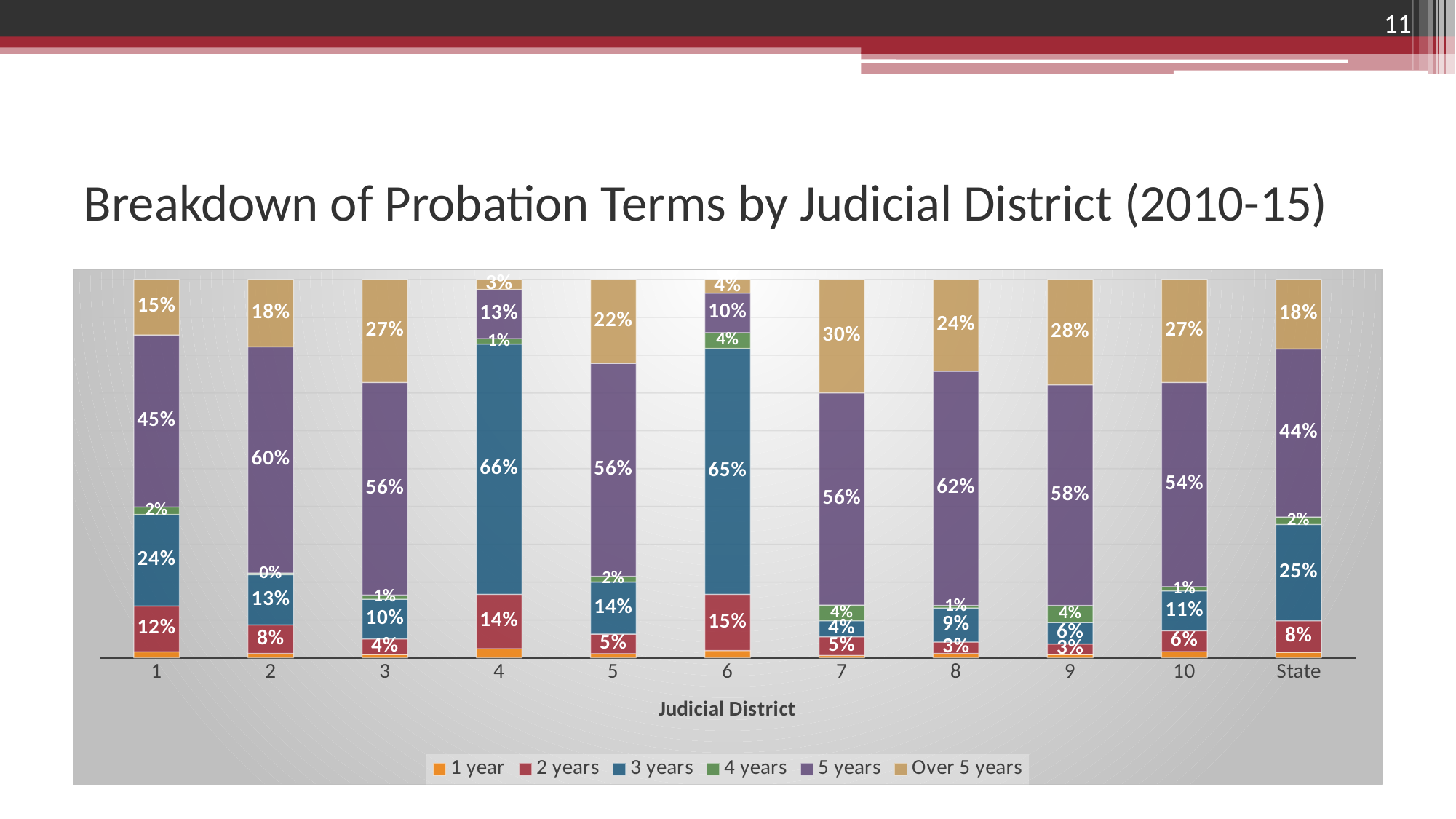
Which judicial district has the highest share of 5-year probation terms? 8 How many series does the legend list? 6 Which judicial district has the lowest share of probation terms over 5 years? 4 Which is larger: the 5 years share in District 2 or the 5 years share in District 9? District 2 Which judicial district has the highest share of probation terms over 5 years? 7 What percentage of probation terms in Judicial District 4 are 3 years? 66% How many judicial district categories are shown on the x axis, including State? 11 What is the difference between the 3 years share in District 4 and the 3 years share in District 1? 42% What kind of chart is shown on the slide? Stacked bar chart What is the 2 years share for Judicial District 6? 15% What percentage of probation terms in Judicial District 7 are over 5 years? 30% What is the State-wide share of probation terms of 5 years? 44%